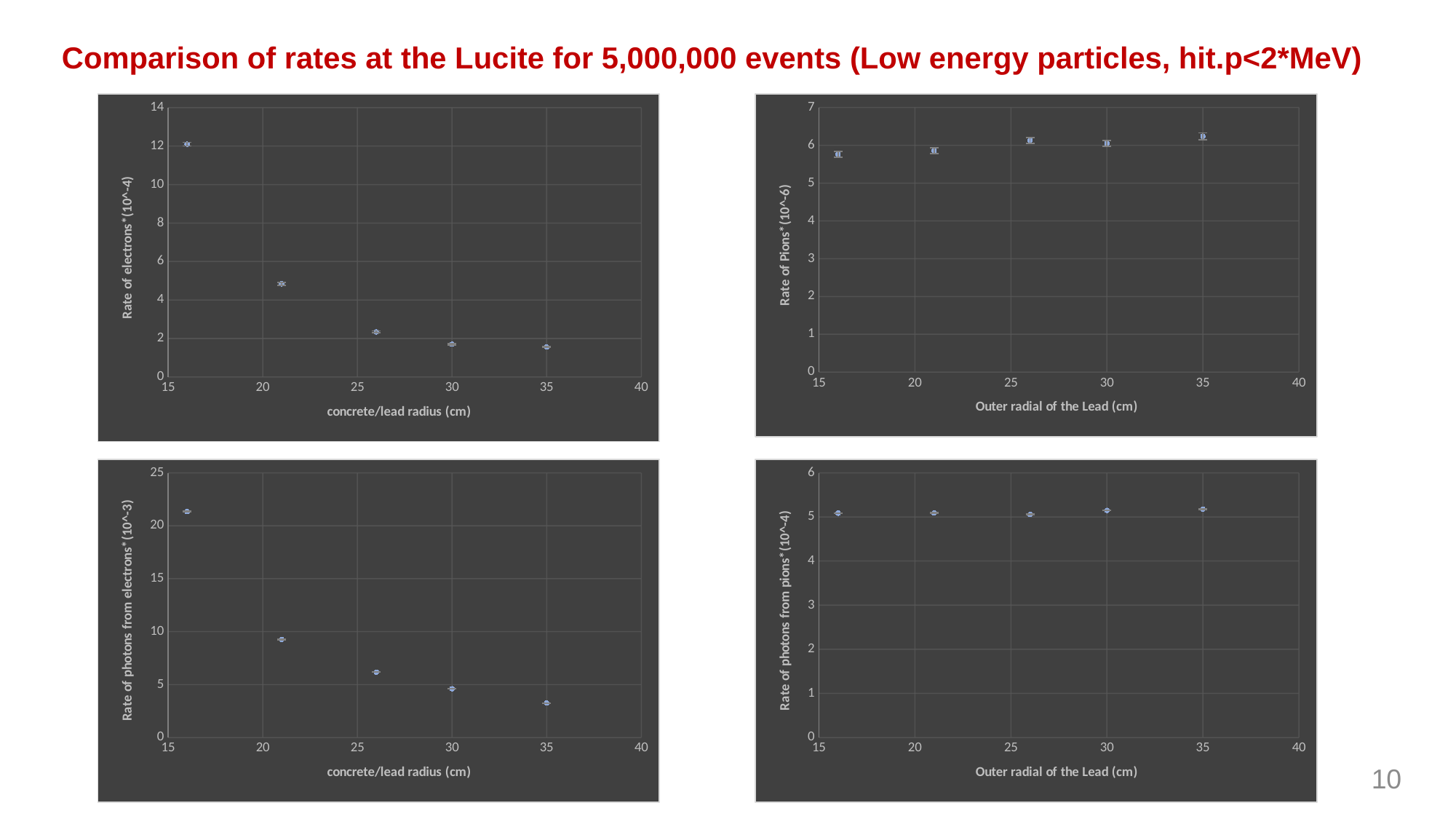
In the bottom-left chart (Rate of photons from electrons), is the value at a radius of about 35 cm greater or less than 5? less In the top-left chart (Rate of electrons), is the value at a radius of about 16 cm greater or less than 10? greater In the bottom-right chart (Rate of photons from pions), is the value at an outer radial of about 30 cm greater or less than 4? greater What is the x-axis label of the top-right chart (Rate of Pions)? Outer radial of the Lead (cm) What kind of chart is the top-right chart (Rate of Pions)? scatter chart In the top-left chart (Rate of electrons), do the values rise or fall as the concrete/lead radius increases? fall In the top-left chart (Rate of electrons), how many data points are plotted? 5 In the bottom-left chart (Rate of photons from electrons), do the values rise or fall as the concrete/lead radius increases? fall